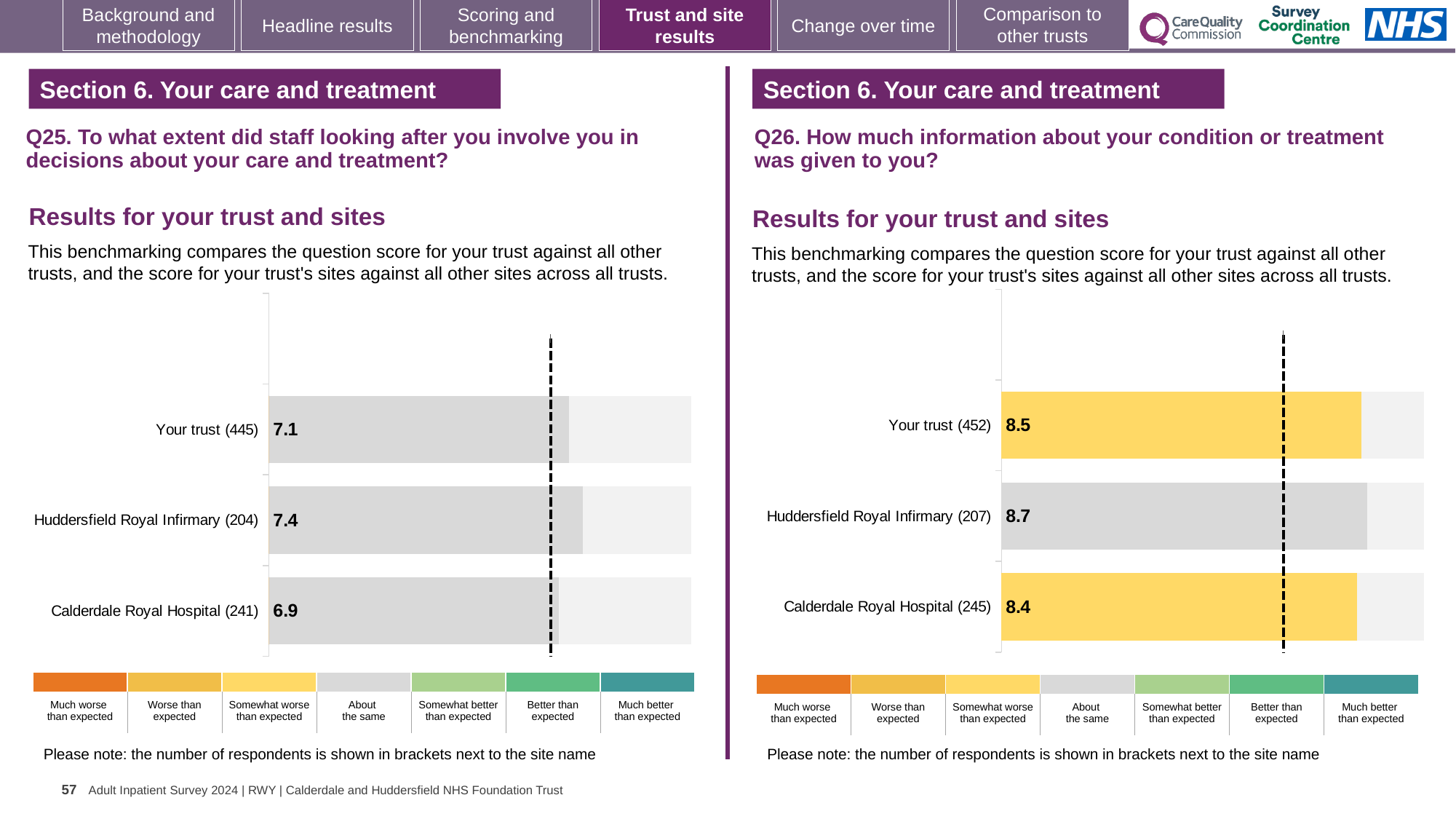
What type of chart is used in the Q26 chart on the right? bar chart How many bars are plotted in the Q25 chart on the left? 3 In the Q26 chart on the right, what is the score for Huddersfield Royal Infirmary? 8.7 In the Q25 chart on the left, how many respondents are shown for Huddersfield Royal Infirmary? 204 In the Q26 chart on the right, how many respondents are shown for Your trust? 452 In the Q26 chart on the right, which site or trust has the lowest score? Calderdale Royal Hospital In the Q25 chart on the left, what is the score for Your trust? 7.1 In the Q25 chart on the left, which site or trust has the highest score? Huddersfield Royal Infirmary In the Q26 chart on the right, what is the difference between the scores for Your trust and Huddersfield Royal Infirmary? 0.2 In the Q26 chart on the right, is the score for Your trust larger or smaller than the score for Calderdale Royal Hospital? larger In the Q25 chart on the left, what is the difference between the scores for Huddersfield Royal Infirmary and Calderdale Royal Hospital? 0.5 In the Q25 chart on the left, what is the score for Calderdale Royal Hospital? 6.9